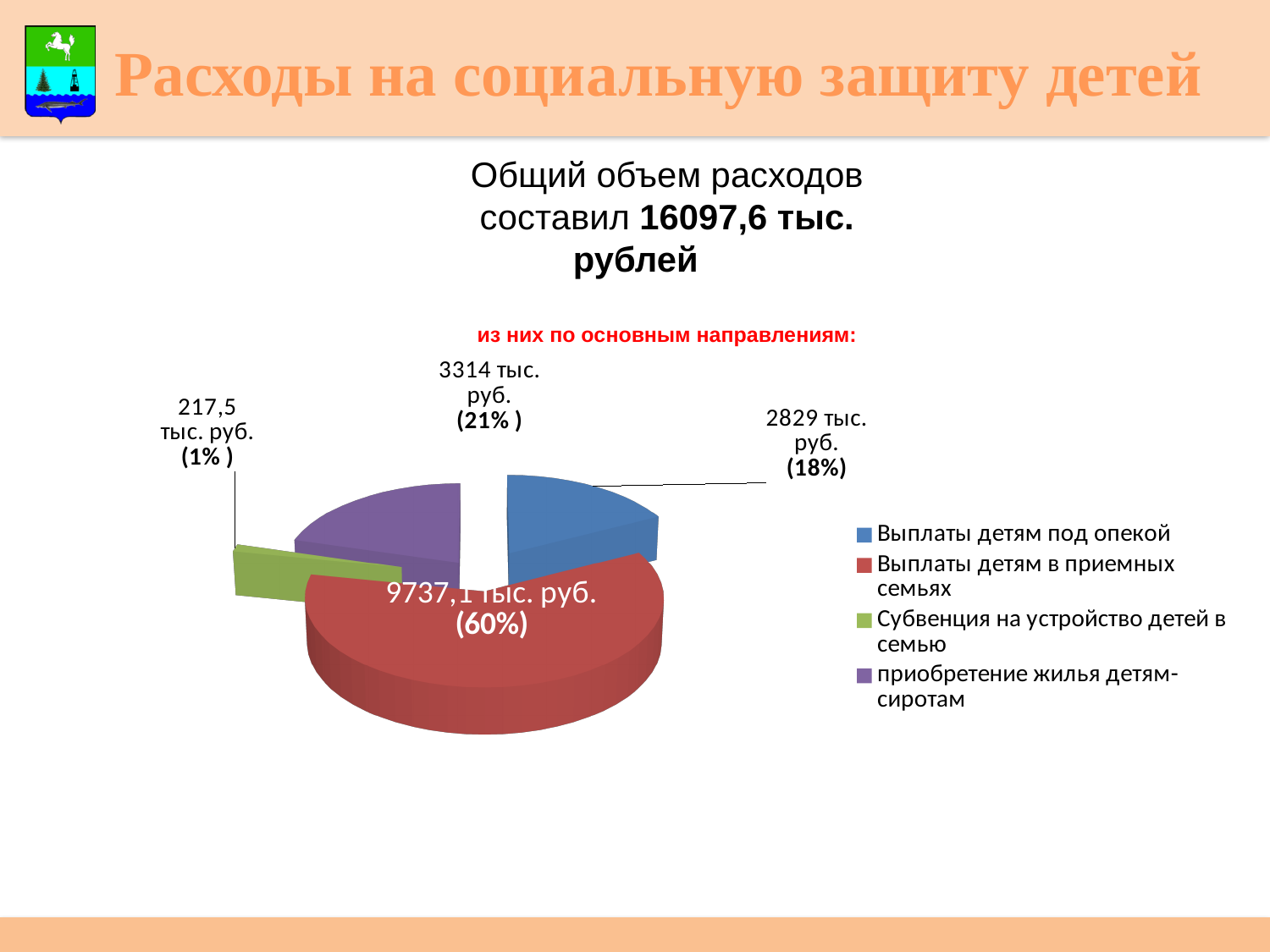
Which category has the largest share of the pie? Выплаты детям в приемных семьях What is the value for "приобретение жилья детям-сиротам"? 3314 тыс. руб. What share of the pie does "приобретение жилья детям-сиротам" represent? 21% What is the value for "Субвенция на устройство детей в семью"? 217,5 тыс. руб. How many entries does the legend of the pie chart list? 4 Which is larger: the value for "Выплаты детям под опекой" or for "приобретение жилья детям-сиротам"? приобретение жилья детям-сиротам Which category has the smallest share of the pie? Субвенция на устройство детей в семью What is the value for "Выплаты детям в приемных семьях"? 9737,1 тыс. руб. What kind of chart is shown on the slide? pie chart What colour is the slice for "Выплаты детям в приемных семьях"? red What is the value for "Выплаты детям под опекой"? 2829 тыс. руб. How many slices does the pie chart have? 4